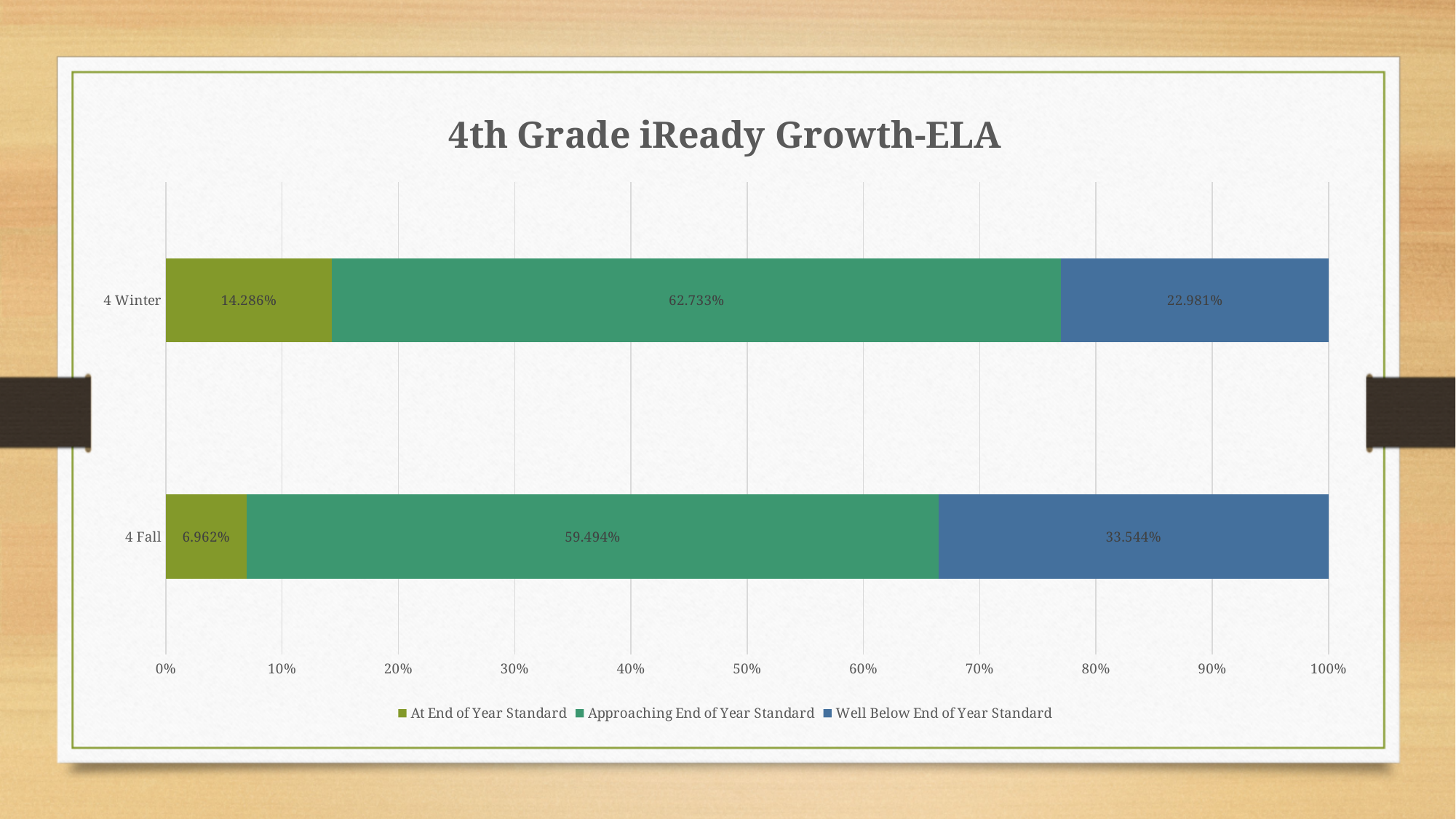
What is the value for At End of Year Standard in 4 Winter? 14.286% What is the value for Approaching End of Year Standard in 4 Winter? 62.733% What is the title of the chart? 4th Grade iReady Growth-ELA How many series does the legend list? 3 What kind of chart is shown on the slide? Stacked bar chart What is the value for Well Below End of Year Standard in 4 Fall? 33.544% What is the difference between the Well Below End of Year Standard values for 4 Fall and 4 Winter? 10.563% How many categories are shown on the chart? 2 What is the difference between the Approaching End of Year Standard values for 4 Winter and 4 Fall? 3.239% Which category has the higher value for Well Below End of Year Standard, 4 Winter or 4 Fall? 4 Fall What is the value for At End of Year Standard in 4 Fall? 6.962% Which category has the lower value for At End of Year Standard? 4 Fall